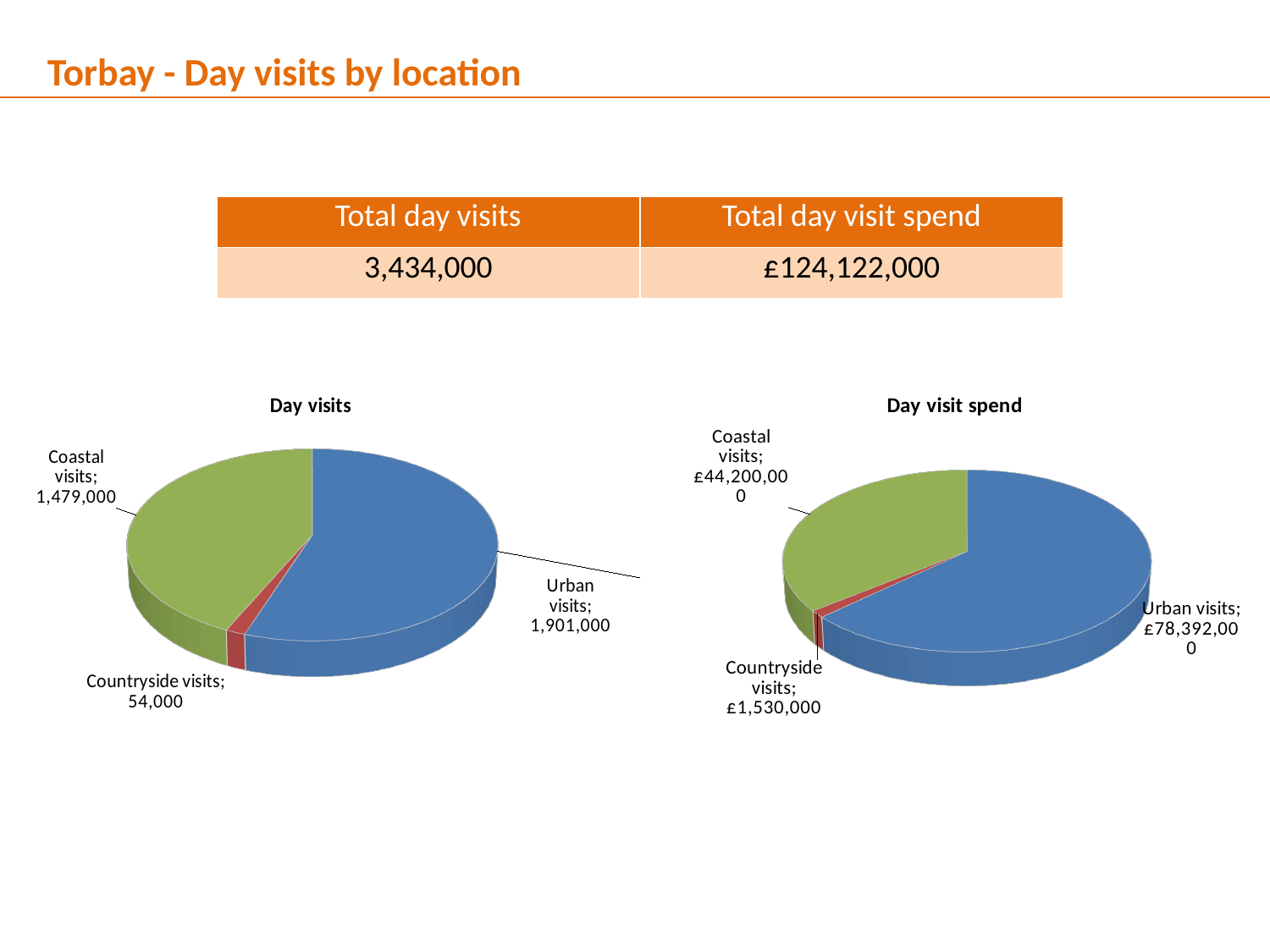
What type of chart is the Day visit spend chart? Pie chart In the Day visits chart, which location type has the largest number of visits? Urban visits In the Day visit spend chart, which location type has the smallest spend? Countryside visits How many slices does the Day visits chart have? 3 In the Day visits chart, what is the difference between urban visits and coastal visits? 422,000 In the Day visits chart, what is the value for coastal visits? 1,479,000 In the Day visits chart, how many day visits were urban visits? 1,901,000 In the Day visit spend chart, what is the spend for countryside visits? £1,530,000 In the Day visit spend chart, what is the spend for urban visits? £78,392,000 In the Day visit spend chart, which is larger: the spend on coastal visits or the spend on countryside visits? Coastal visits In the Day visit spend chart, how much more was spent on urban visits than on coastal visits? £34,192,000 In the Day visit spend chart, what share of the total spend comes from urban visits? 63%